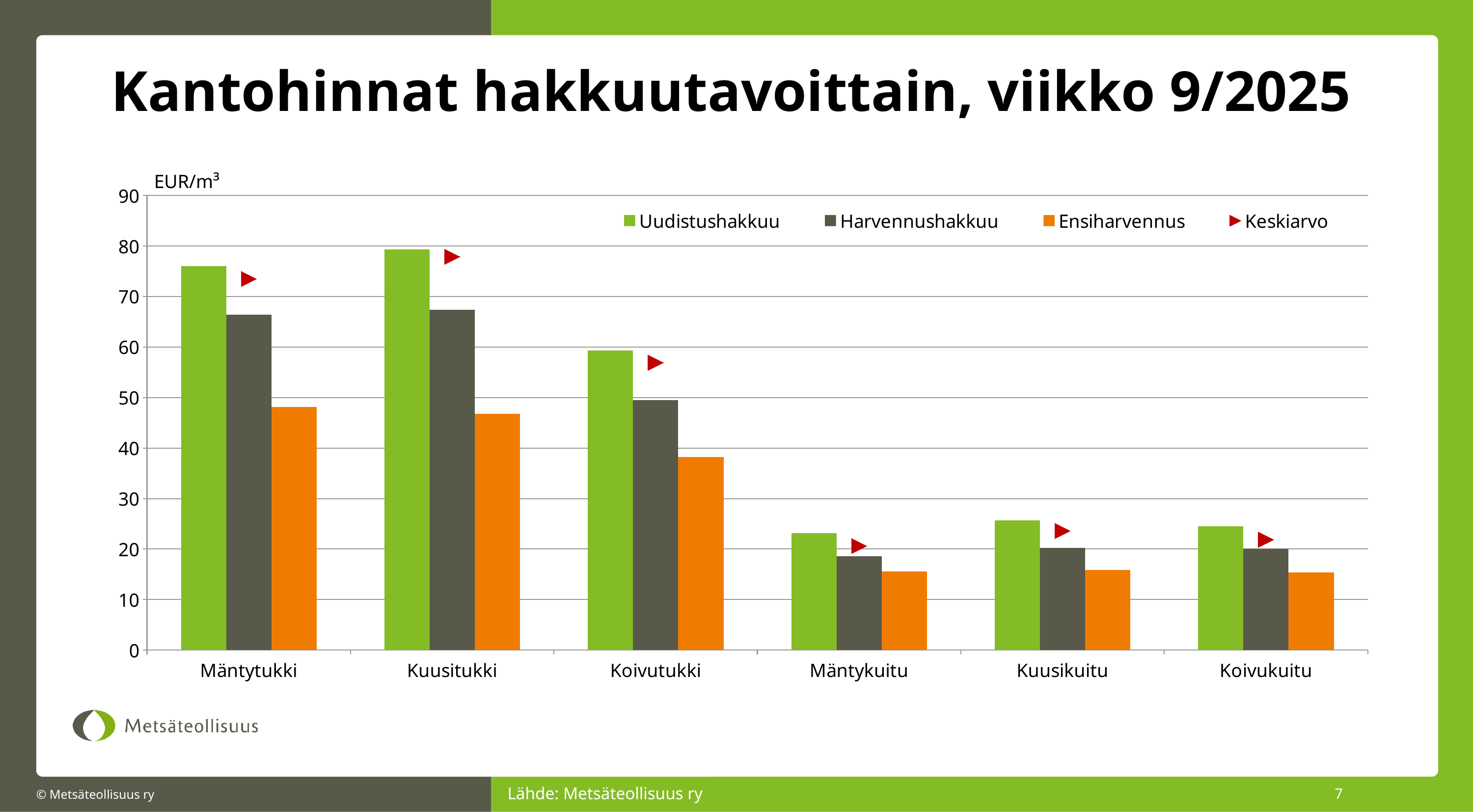
What unit is shown on the y axis? EUR/m³ How many series does the legend list? 4 How many categories are shown on the x axis? 6 Which category has the highest Uudistushakkuu value? Kuusitukki Is the Ensiharvennus value for Mäntykuitu greater or less than 20? less Is the Harvennushakkuu value for Kuusitukki greater or less than 60? greater What kind of chart is shown on the slide? bar chart Is the Ensiharvennus value for Koivutukki greater or less than 40? less Which series is shown with orange bars? Ensiharvennus Which is larger, the Harvennushakkuu value for Kuusitukki or for Mäntykuitu? Kuusitukki Which is larger, the Uudistushakkuu value for Mäntytukki or for Koivutukki? Mäntytukki